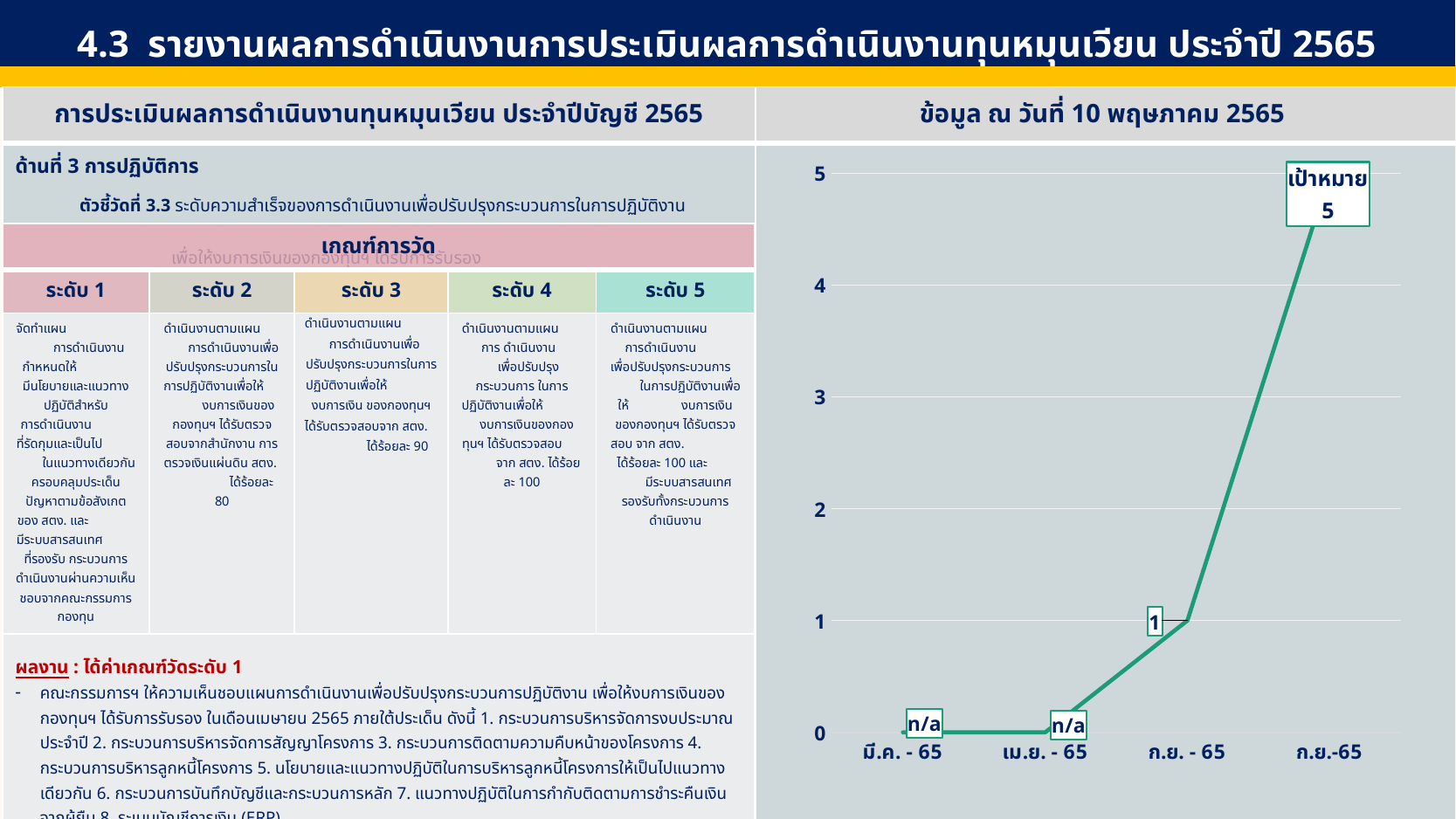
What is the data label on the third point from the left (ก.ย. - 65) on the line chart? 1 Is the value at the last point of the line chart greater or less than 4? greater What is the highest tick value shown on the y axis of the line chart? 5 How many points (x-axis categories) are plotted on the line chart? 4 What value is shown in the เป้าหมาย (target) label at the last point of the line chart? 5 Which is larger on the line chart: the value at the third point (1) or the target value at the last point? the target value at the last point Which point on the line chart has the highest value? the last point (เป้าหมาย 5) Does the line rise or fall from left to right across the x axis? rises What kind of chart is shown on the right side of the slide? line chart What is the data label on the second point (เม.ย. - 65) on the line chart? n/a What is the data label on the first point (มี.ค. - 65) on the line chart? n/a What is the difference between the target value at the last point and the value at the third point (ก.ย. - 65)? 4